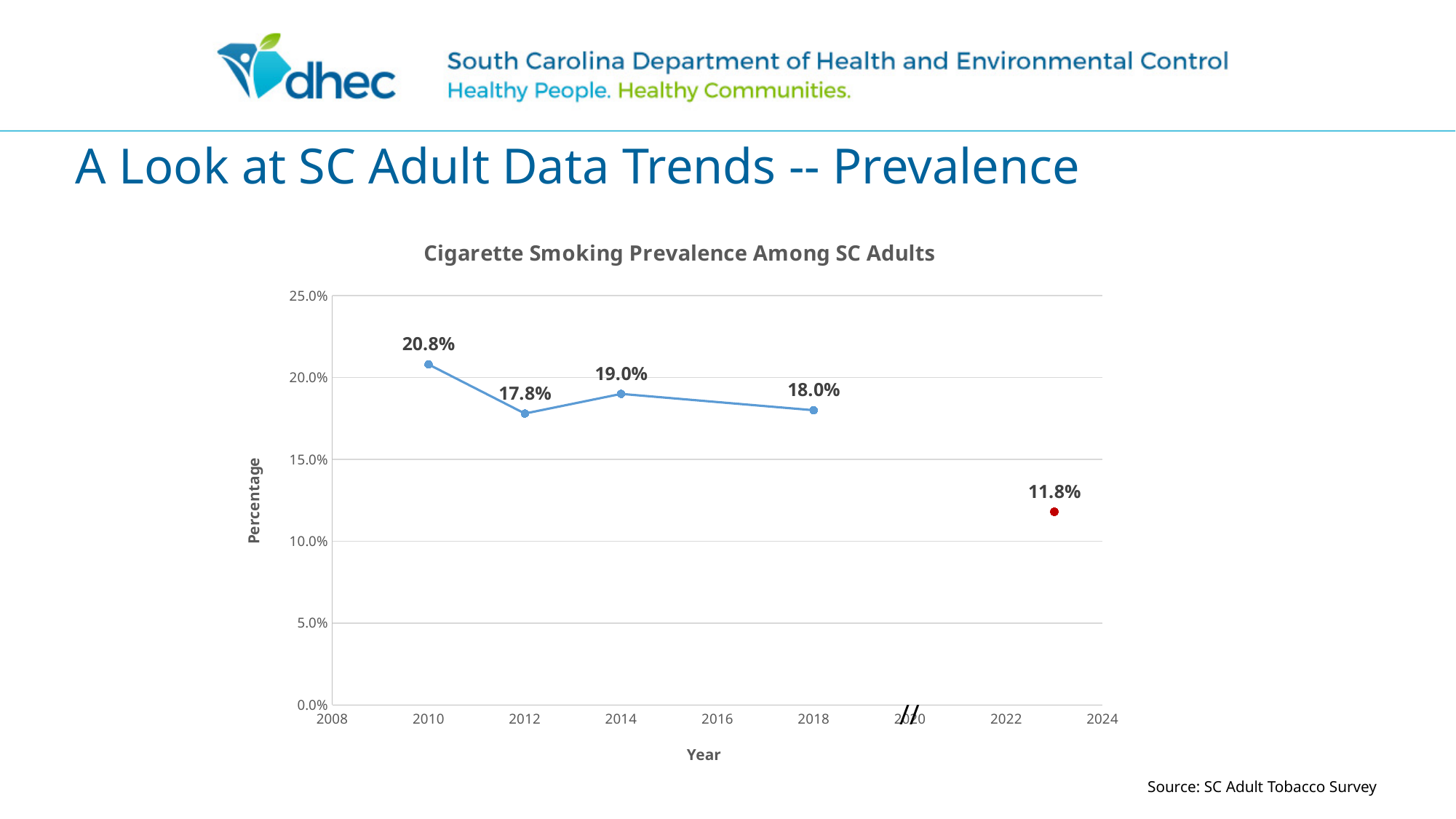
What was the cigarette smoking prevalence among SC adults in 2010? 20.8% What was the cigarette smoking prevalence among SC adults in 2014? 19.0% What was the cigarette smoking prevalence among SC adults in 2018? 18.0% What type of chart is shown on the slide? line chart How many data points are plotted on the chart? 5 What is the title of the chart? Cigarette Smoking Prevalence Among SC Adults What is the label on the y-axis? Percentage Which year had a higher prevalence, 2014 or 2018? 2014 What was the cigarette smoking prevalence among SC adults in 2012? 17.8% What is the difference in prevalence between 2010 and 2012? 3.0% What value is shown for the red data point on the right side of the chart? 11.8% In which year was cigarette smoking prevalence highest? 2010